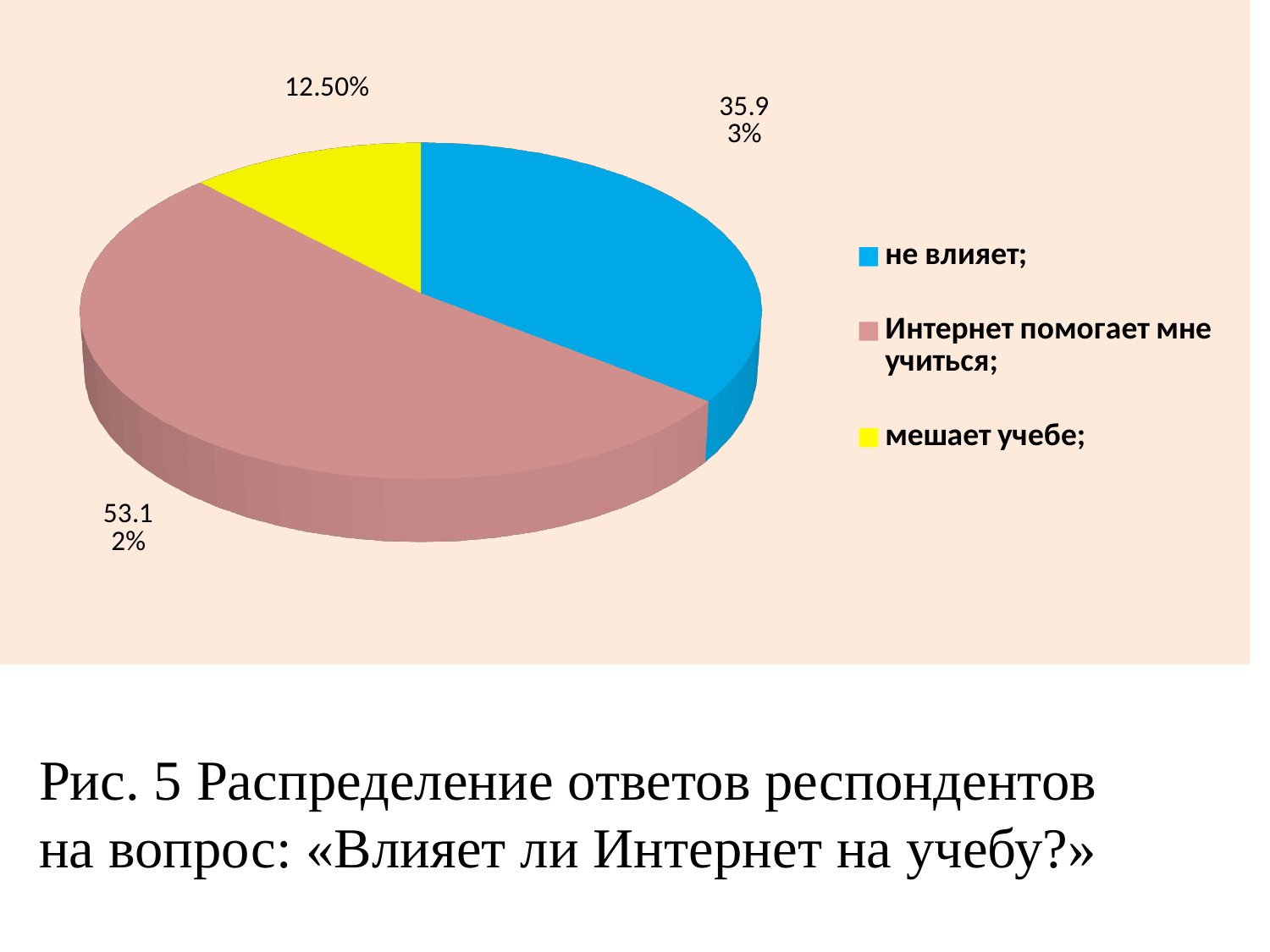
What is the difference in percentage points between "Интернет помогает мне учиться" and "не влияет"? 17.19 How many entries does the legend list? 3 Which answer has the largest share of the pie? Интернет помогает мне учиться What type of chart is shown on the slide? pie chart What is the difference in percentage points between "не влияет" and "мешает учебе"? 23.43 What colour is the slice for "мешает учебе"? yellow What percentage of respondents answered "не влияет"? 35.93% How many slices does the pie chart have? 3 What percentage of respondents answered "Интернет помогает мне учиться"? 53.12% Which is larger: the share for "не влияет" or the share for "мешает учебе"? не влияет Which answer has the smallest share of the pie? мешает учебе What percentage of respondents answered "мешает учебе"? 12.50%